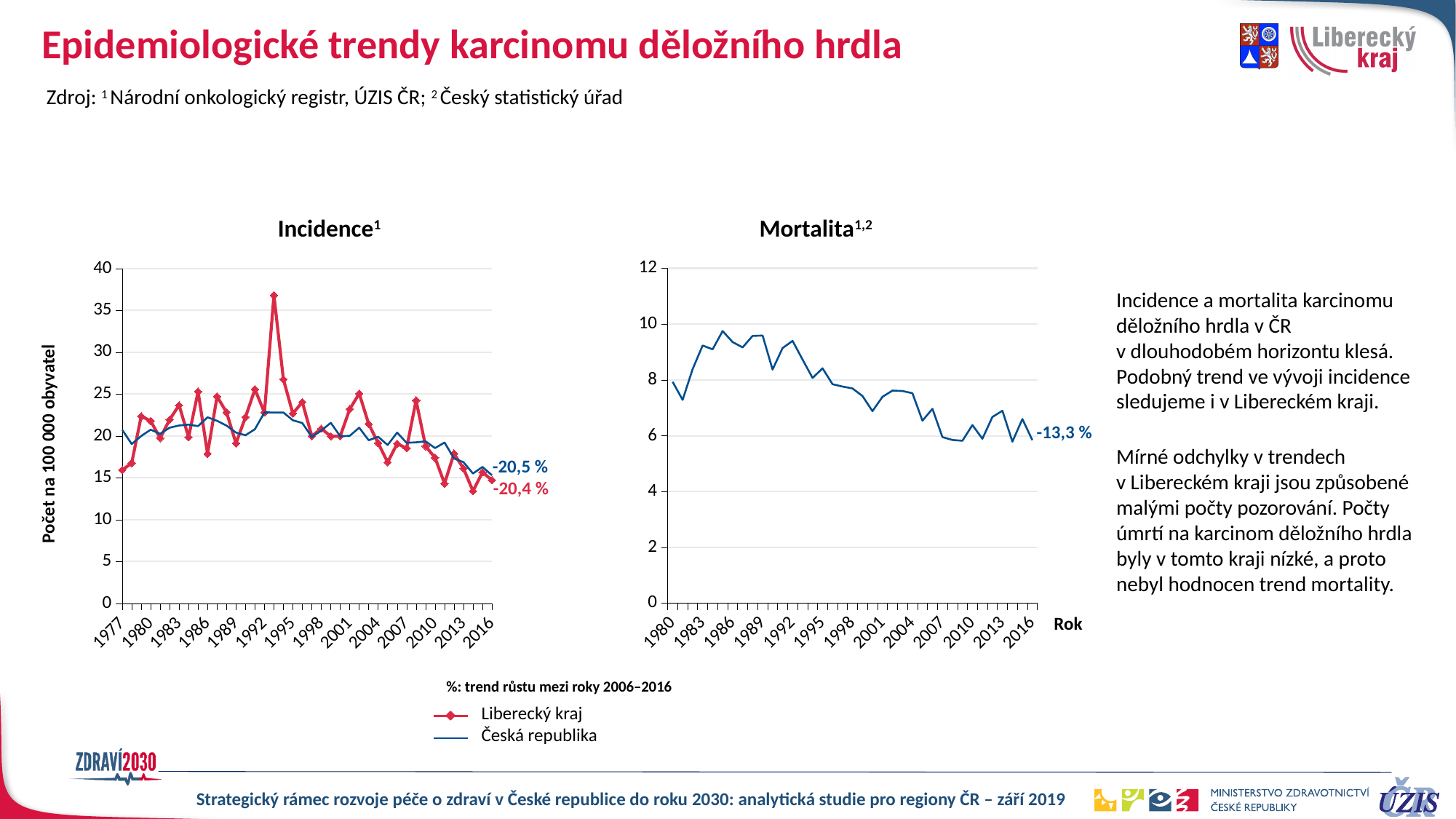
In the Mortalita chart, do the values overall rise or fall from 1980 to 2016? fall In the Mortalita chart, is the value for 2016 greater or less than 8? less In the Incidence chart, is the peak value of the Liberecký kraj series greater or less than 35? greater In the Mortalita chart, is the value for 1986 greater or less than 8? greater In the Incidence chart, what trend percentage is shown for Česká republika? -20,5 % How many series does the legend list for the Incidence chart? 2 In the Incidence chart, which series reaches the highest peak value? Liberecký kraj In the Incidence chart, what trend percentage is shown for Liberecký kraj? -20,4 % What is the y-axis label of the Incidence chart? Počet na 100 000 obyvatel In the Mortalita chart, what trend percentage is shown at the end of the line? -13,3 % What kind of chart is the Incidence chart? line chart